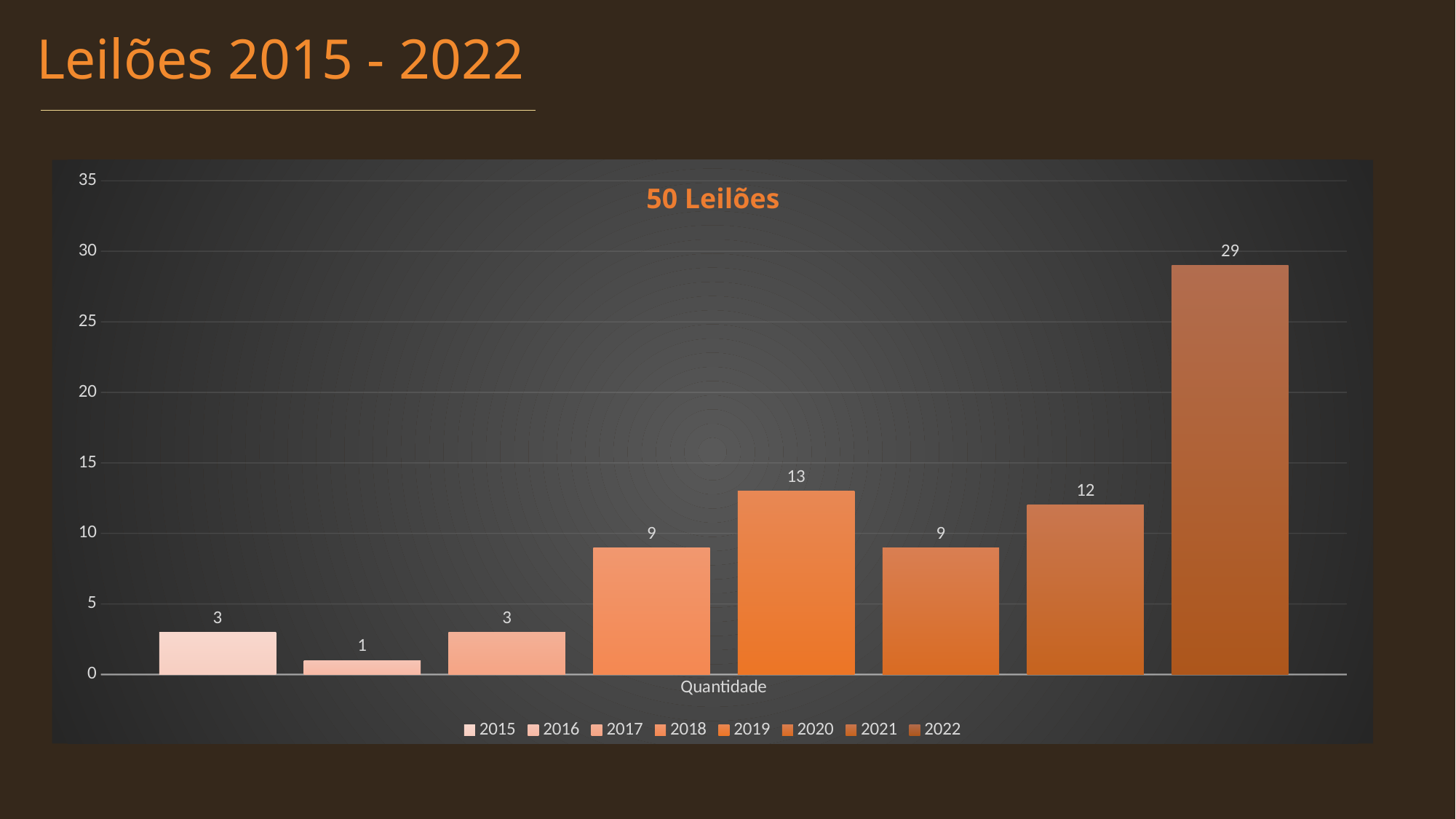
What is the difference between the values for 2022 and 2021? 17 Which year has the lowest value? 2016 What is the value for 2019? 13 Which year has the highest value? 2022 Which is larger, the value for 2019 or the value for 2021? 2019 What is the value for 2016? 1 What is the label on the x axis? Quantidade What is the value for 2022? 29 How many series does the legend list? 8 What is the difference between the values for 2019 and 2018? 4 What is the chart title shown inside the plot area? 50 Leilões What kind of chart is shown? bar chart